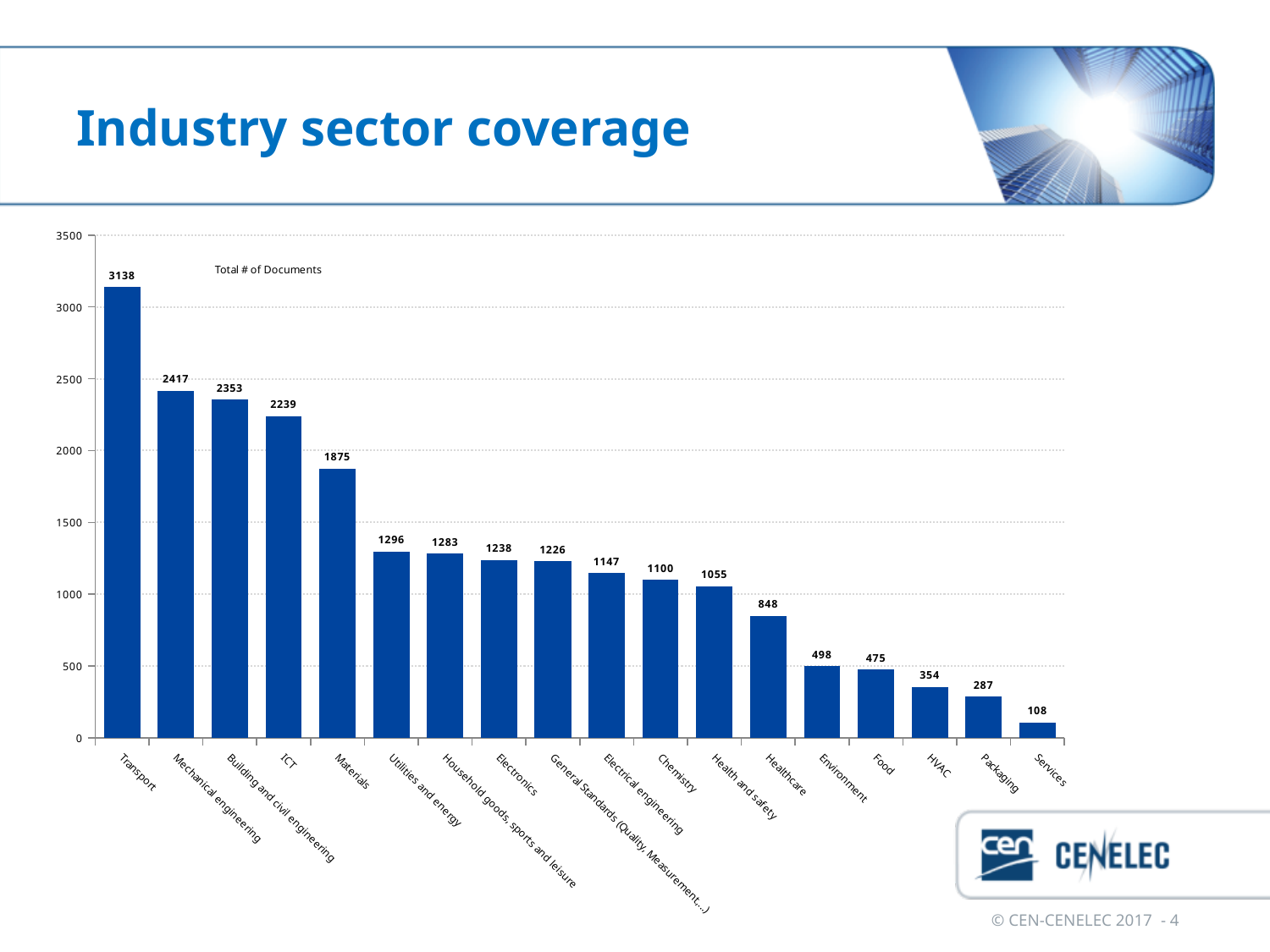
What is the value for HVAC? 354 Which is larger, the value for Chemistry or the value for Electrical engineering? Electrical engineering What is the value for Transport? 3138 Which category has the lowest value? Services Do the values rise or fall from left to right along the x axis? fall Which category has the highest value? Transport What kind of chart is shown on the slide? bar chart What is the difference between the values for Mechanical engineering and ICT? 178 Is the value for Environment greater or less than 1000? less What is the value for Materials? 1875 What is the value for Healthcare? 848 How many categories are shown on the x axis? 18